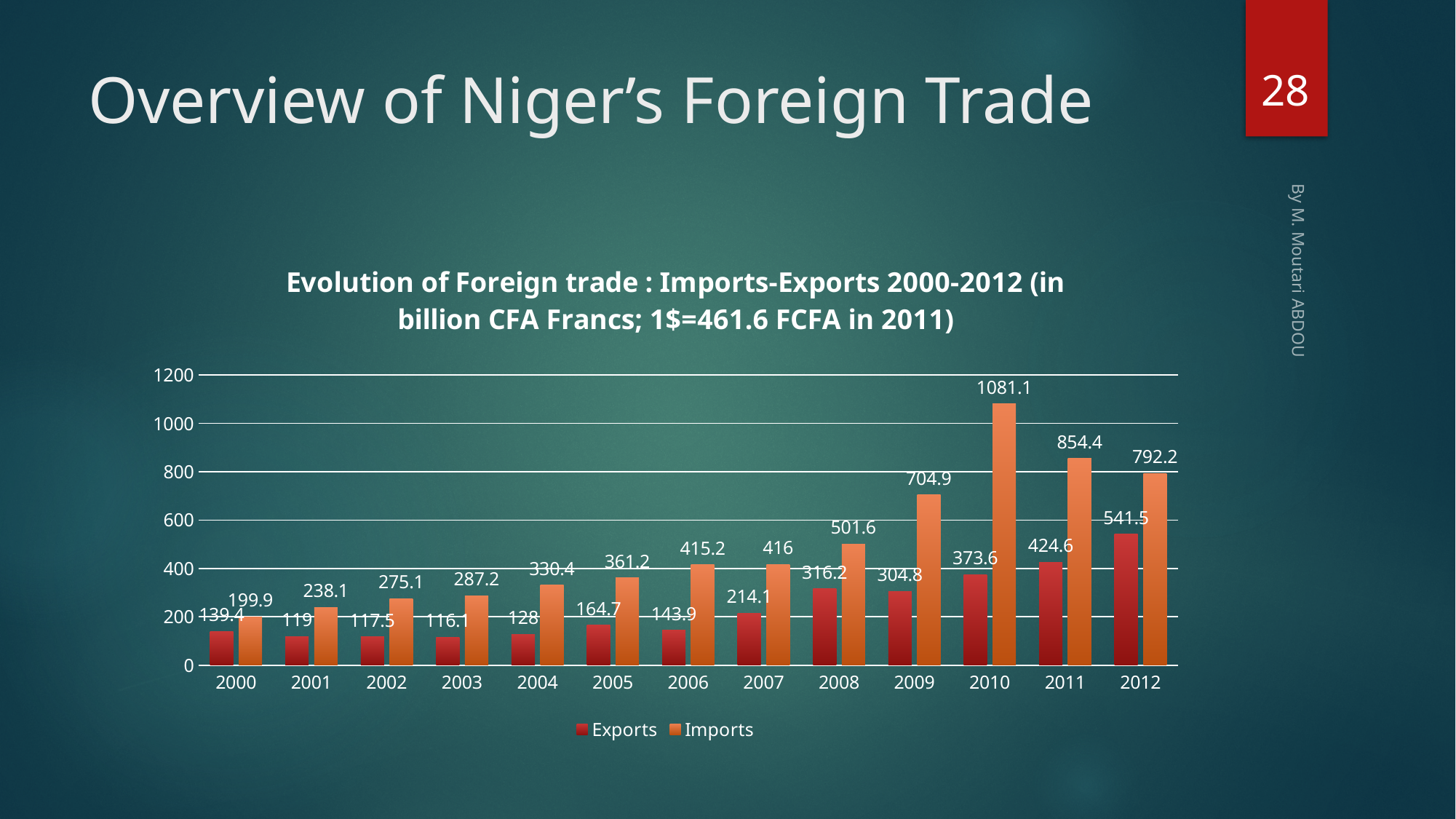
How many series does the legend list? 2 In which year are Imports highest? 2010 What colour are the Imports bars? Orange Which is larger in 2009, Exports or Imports? Imports How many years are shown on the x axis? 13 What is the value of Exports in 2012? 541.5 What is the value of Imports in 2010? 1081.1 Do Imports generally rise or fall from 2000 to 2010? Rise What is the difference between Imports and Exports in 2011? 429.8 What is the value of Exports in 2007? 214.1 What kind of chart is shown on the slide? Bar chart In which year are Exports lowest? 2003